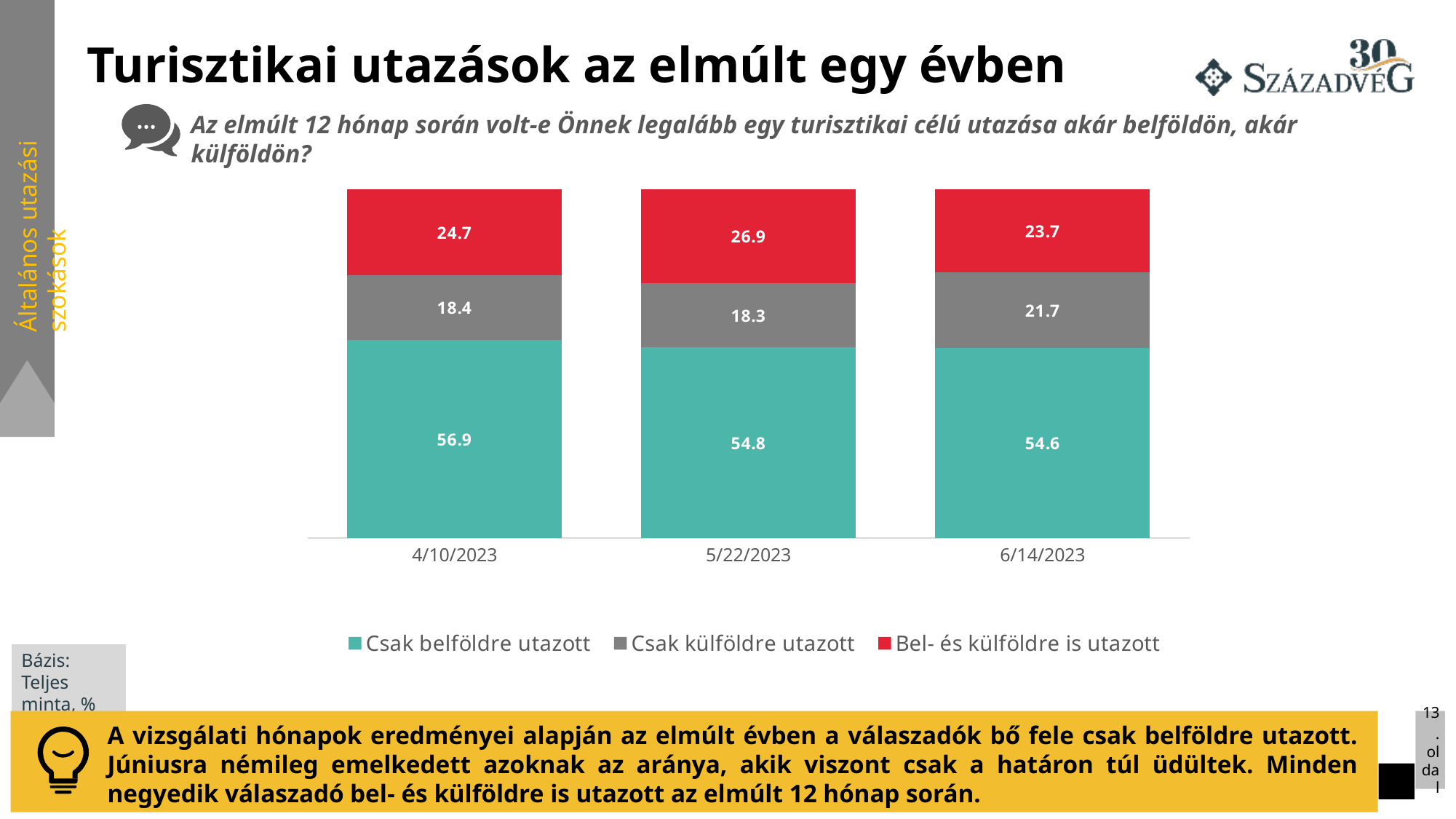
What is the value for 'Bel- és külföldre is utazott' on 5/22/2023? 26.9 How many dates (categories) are shown on the x axis? 3 What is the total of the stacked bar for 5/22/2023? 100.0 What is the value for 'Csak belföldre utazott' on 4/10/2023? 56.9 Which colour represents 'Csak belföldre utazott' in the chart? Teal (green) What is the difference between the 'Csak külföldre utazott' values on 6/14/2023 and 5/22/2023? 3.4 On which date is the 'Csak belföldre utazott' value lowest? 6/14/2023 Which is larger: 'Bel- és külföldre is utazott' on 4/10/2023 or on 6/14/2023? 4/10/2023 What is the value for 'Csak külföldre utazott' on 6/14/2023? 21.7 What kind of chart is shown on the slide? Stacked bar chart On which date is the 'Bel- és külföldre is utazott' value highest? 5/22/2023 How many series does the legend list? 3